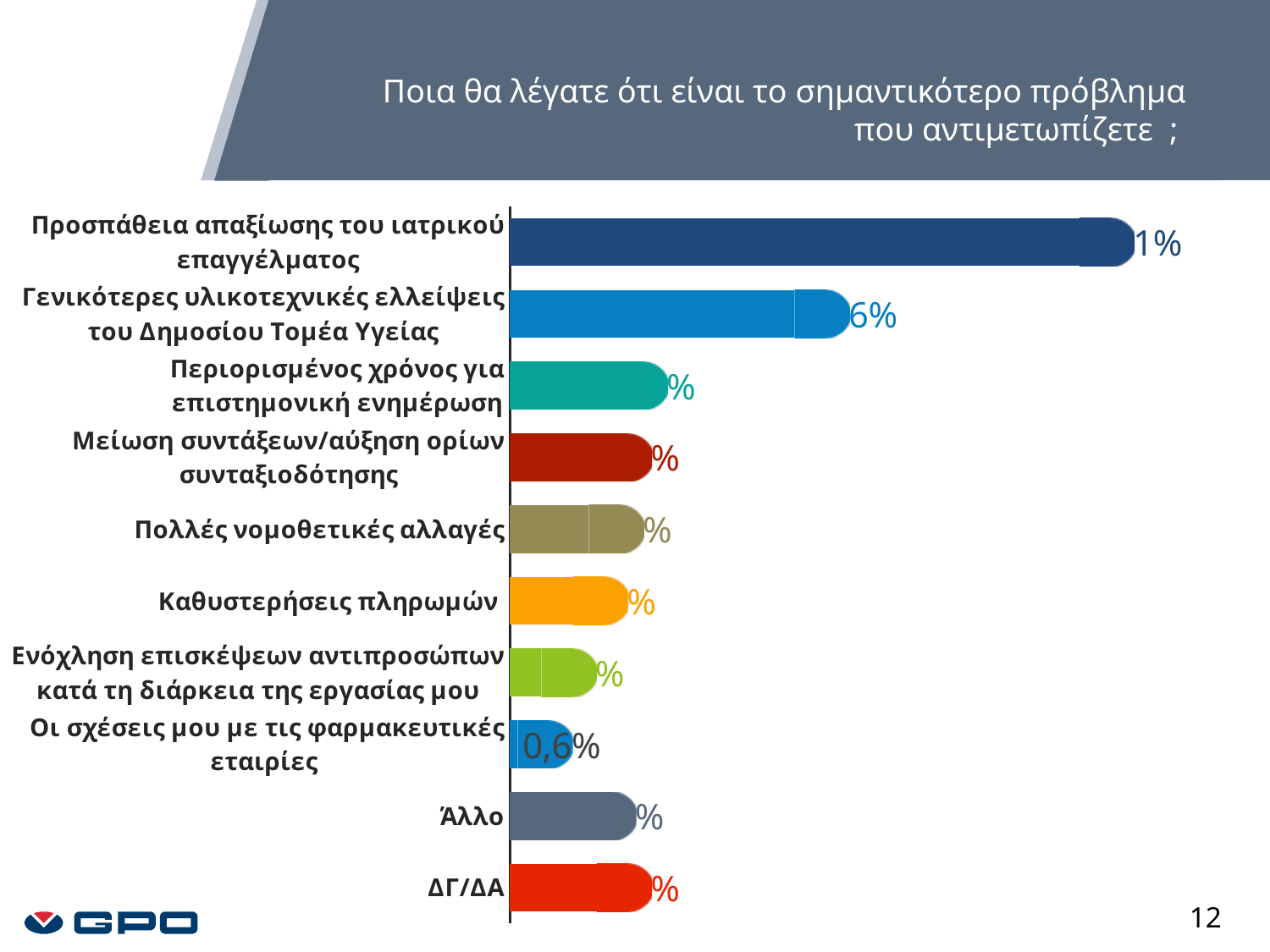
Which has the larger value: 'Προσπάθεια απαξίωσης του ιατρικού επαγγέλματος' or 'Γενικότερες υλικοτεχνικές ελλείψεις του Δημοσίου Τομέα Υγείας'? Προσπάθεια απαξίωσης του ιατρικού επαγγέλματος Which has the larger value: 'Καθυστερήσεις πληρωμών' or 'Οι σχέσεις μου με τις φαρμακευτικές εταιρίες'? Καθυστερήσεις πληρωμών Which category has the longest bar in the chart? Προσπάθεια απαξίωσης του ιατρικού επαγγέλματος What is the value shown for 'Οι σχέσεις μου με τις φαρμακευτικές εταιρίες'? 0,6% Which has the larger value: 'Μείωση συντάξεων/αύξηση ορίων συνταξιοδότησης' or 'Ενόχληση επισκέψεων αντιπροσώπων κατά τη διάρκεια της εργασίας μου'? Μείωση συντάξεων/αύξηση ορίων συνταξιοδότησης What kind of chart is shown on the slide? bar chart Which category is listed last (at the bottom) of the chart? ΔΓ/ΔΑ Which category has the shortest bar in the chart? Οι σχέσεις μου με τις φαρμακευτικές εταιρίες What is the title of the chart on the slide? Ποια θα λέγατε ότι είναι το σημαντικότερο πρόβλημα που αντιμετωπίζετε ; How many categories are plotted in the chart? 10